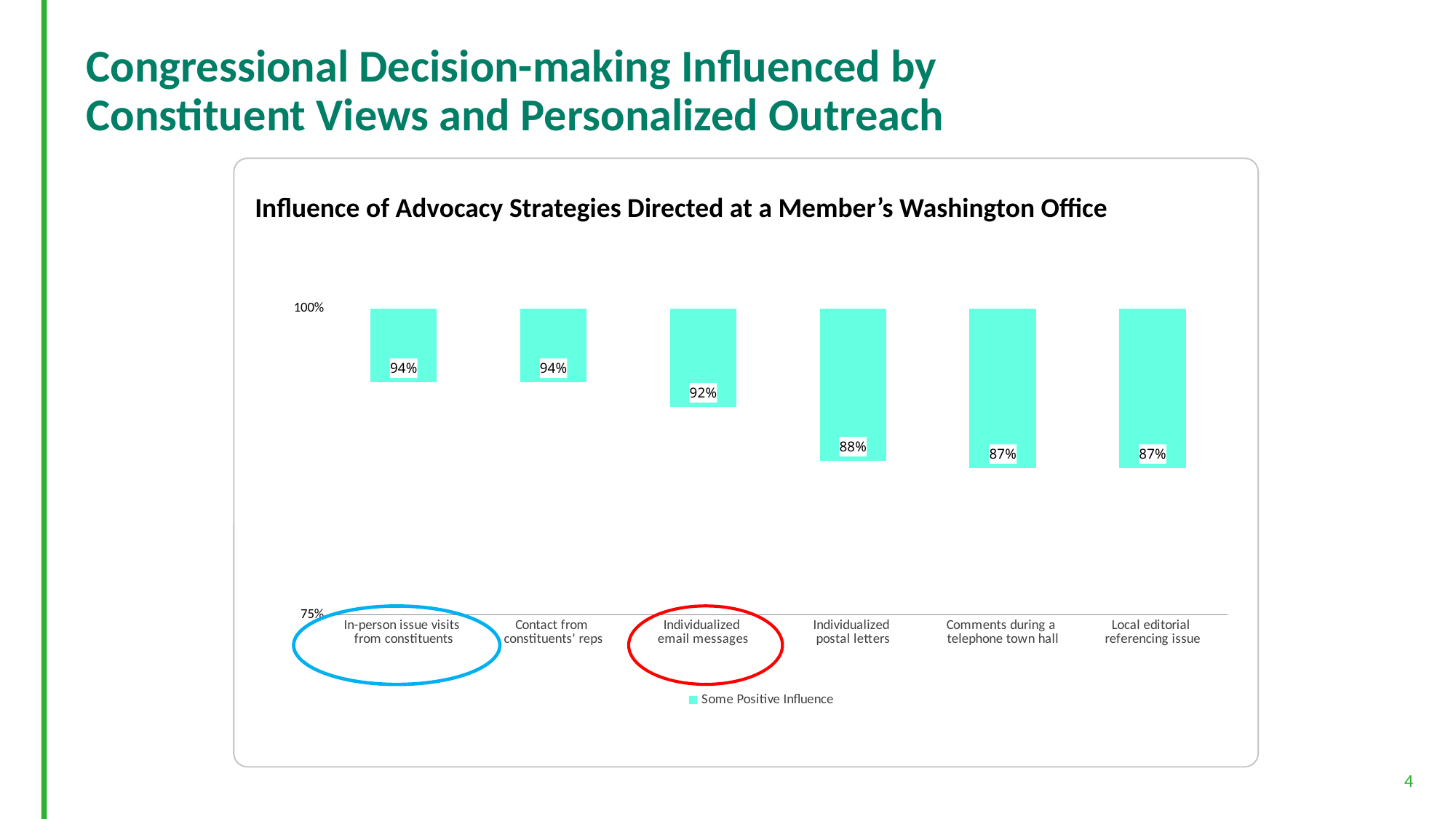
Is the value for Comments during a telephone town hall greater or less than 75%? greater What is the difference between the value for Individualized email messages and the value for Local editorial referencing issue? 5 percentage points What value is shown for Local editorial referencing issue? 87% What value is shown for Individualized postal letters? 88% What value is shown for In-person issue visits from constituents? 94% How many categories are shown on the x axis of the chart? 6 Which is larger, the value for Contact from constituents' reps or the value for Individualized postal letters? Contact from constituents' reps How many series does the legend list? 1 What value is shown for Comments during a telephone town hall? 87% Do the values rise or fall moving from left to right along the x axis? fall What is the difference between the value for In-person issue visits from constituents and the value for Individualized postal letters? 6 percentage points What value is shown for Individualized email messages? 92%